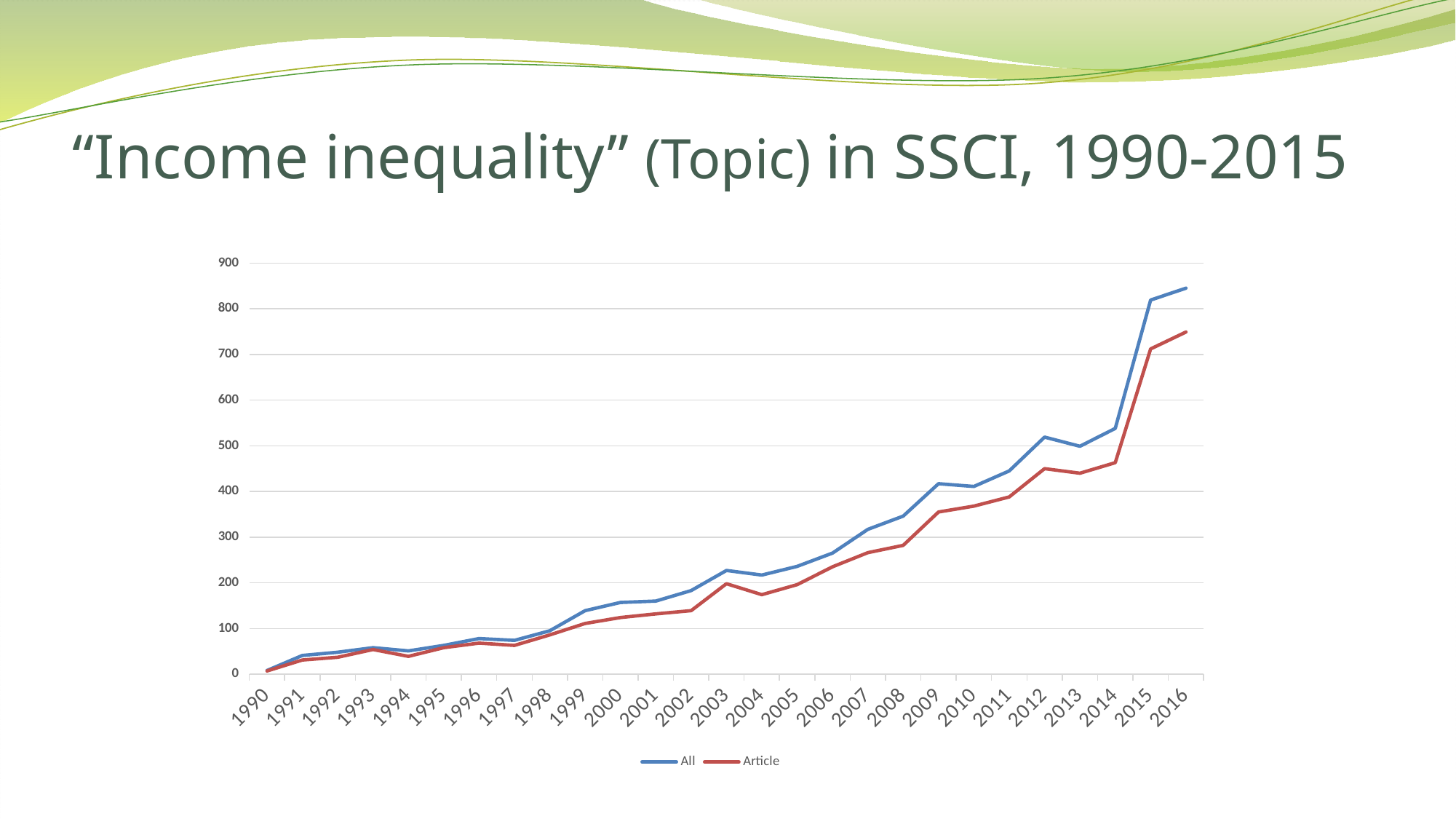
What kind of chart is shown on the slide? line chart In which year does the All series reach its highest value? 2016 Which colour is used for the Article series line? red Is the value for Article in 2016 greater or less than 700? greater Is the value for Article in 2004 greater or less than 200? less How many series does the legend list? 2 Do the values for the All series generally rise or fall from 1990 to 2016? rise What are the names of the two series in the legend? All and Article In which year does the Article series have its lowest value? 1990 Is the value for All in 2015 greater or less than 800? greater In 2016, which series has the larger value, All or Article? All How many years are plotted along the x axis? 27